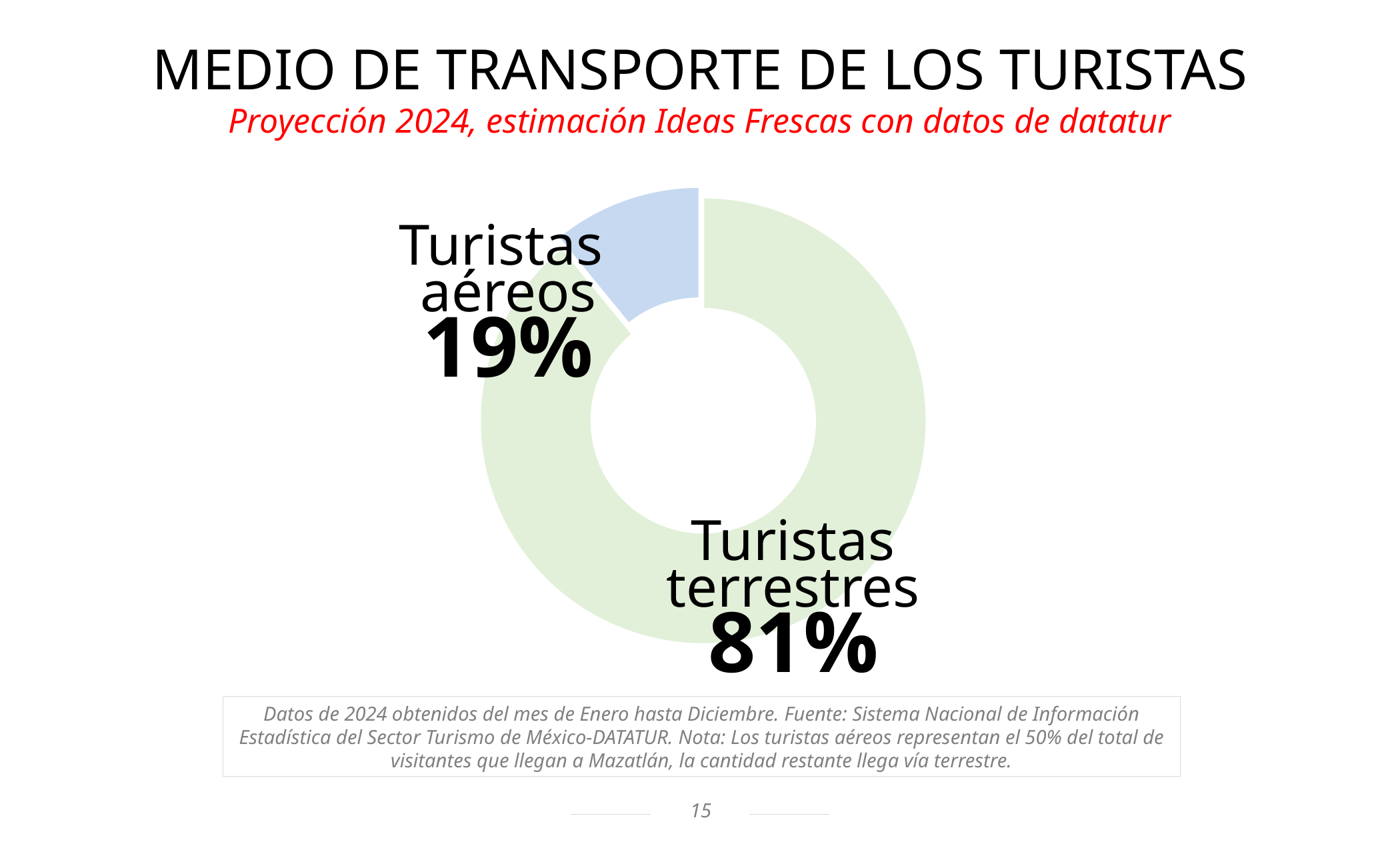
Which category has the smallest share of the chart? Turistas aéreos What is the difference in percentage points between Turistas terrestres and Turistas aéreos? 62 What percentage of tourists are Turistas aéreos? 19% How many categories does the chart show? 2 Which is larger, the share of Turistas aéreos or Turistas terrestres? Turistas terrestres What percentage of tourists are Turistas terrestres? 81% What colour is the Turistas terrestres segment of the chart? Light green What is the title of the slide containing the chart? MEDIO DE TRANSPORTE DE LOS TURISTAS What kind of chart is shown on the slide? Doughnut (pie) chart What share of the pie does the Turistas aéreos slice represent? 19% Which category has the largest share of the chart? Turistas terrestres